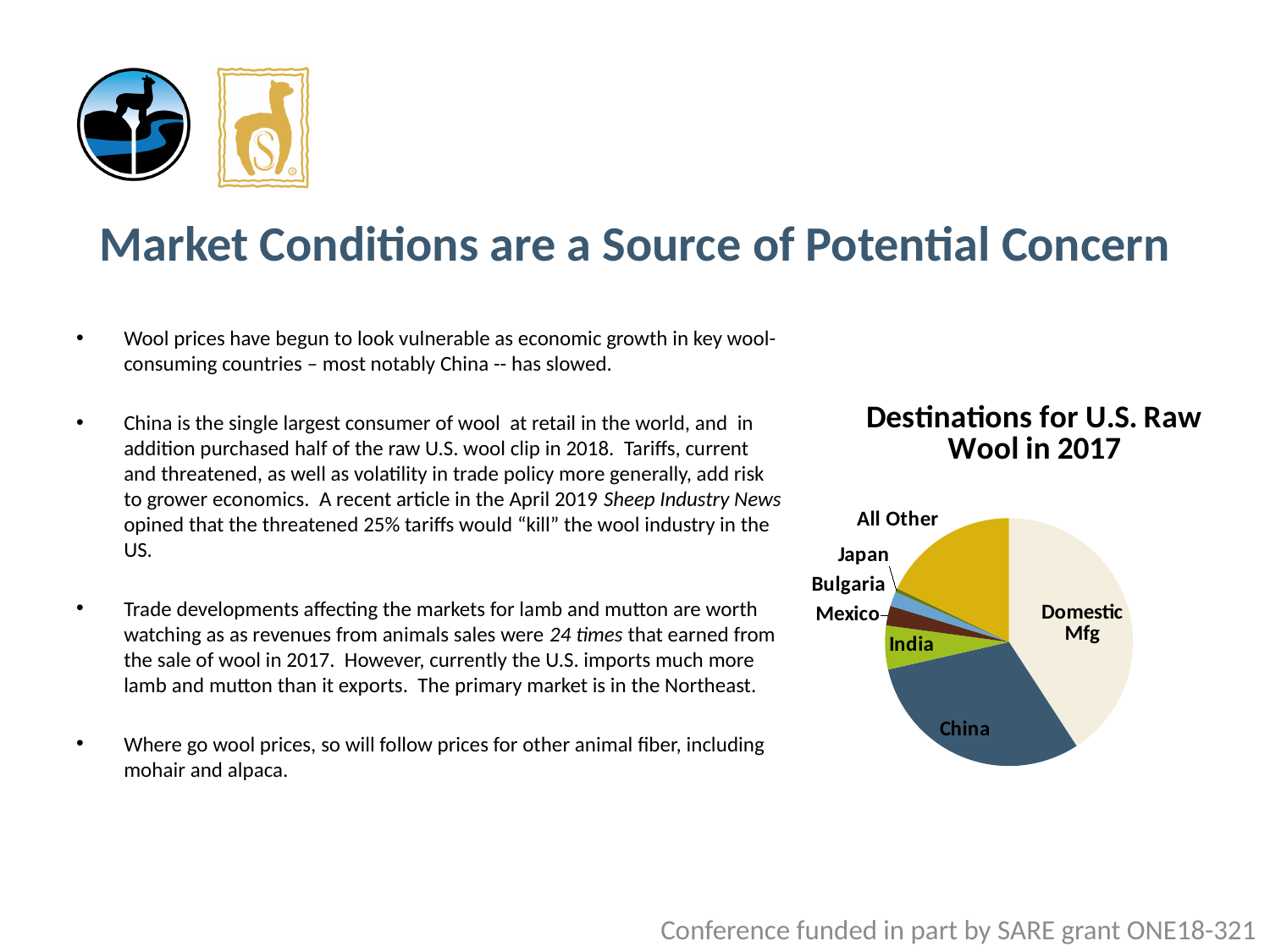
Which destination has the largest slice of the pie chart? Domestic Mfg Which year does the pie chart describe? 2017 How many slices does the pie chart have? 7 Which slice is larger, All Other or Mexico? All Other Which slice is larger, Domestic Mfg or All Other? Domestic Mfg Which slice is larger, China or India? China What is the title of the chart on the slide? Destinations for U.S. Raw Wool in 2017 What kind of chart is shown on the slide? Pie chart